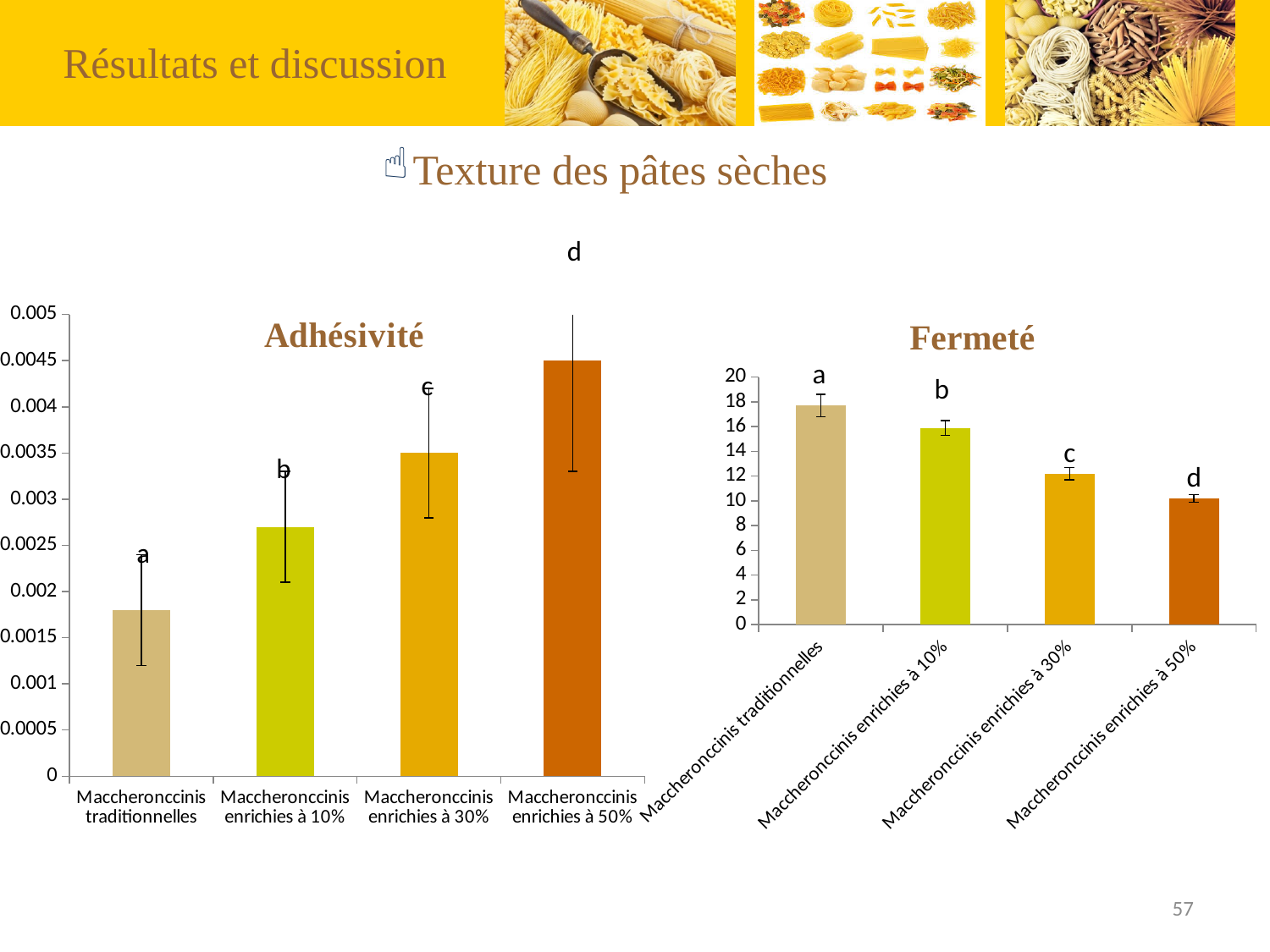
In the Fermeté chart, which is larger: the value for Maccheronccinis enrichies à 10% or Maccheronccinis enrichies à 30%? Maccheronccinis enrichies à 10% In the Fermeté chart, is the value for Maccheronccinis traditionnelles greater or less than 16? greater In the Fermeté chart, which category has the highest value? Maccheronccinis traditionnelles In the Adhésivité chart, which category has the highest value? Maccheronccinis enrichies à 50% In the Fermeté chart, which category has the lowest value? Maccheronccinis enrichies à 50% In the Fermeté chart, do the values rise or fall from left to right along the x axis? fall How many categories are shown in the Fermeté chart? 4 In the Adhésivité chart, do the values rise or fall from left to right along the x axis? rise What type of chart is the Adhésivité chart? bar chart In the Adhésivité chart, which category has the lowest value? Maccheronccinis traditionnelles In the Fermeté chart, is the value for Maccheronccinis enrichies à 50% greater or less than 12? less